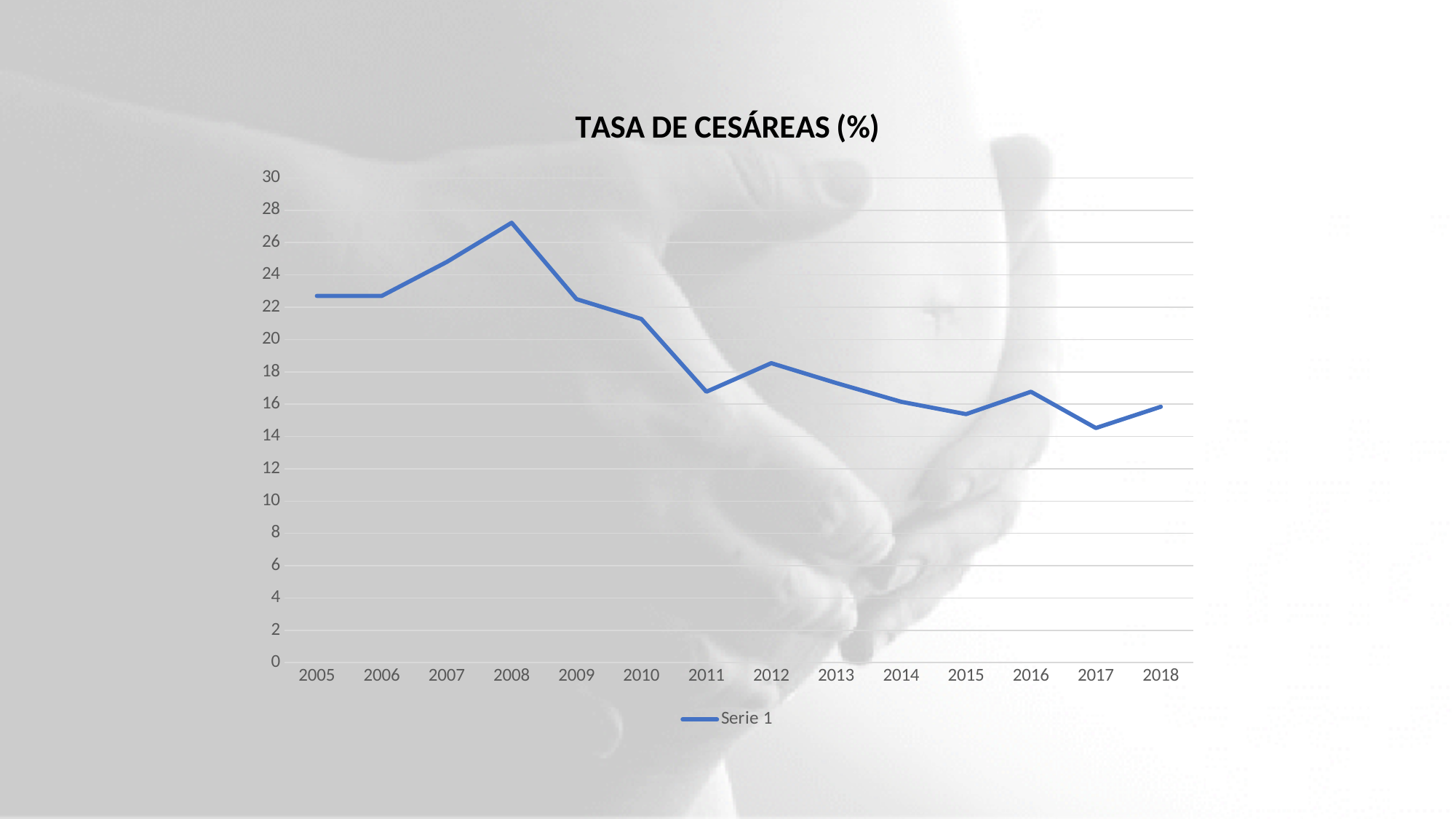
In which year is the cesarean rate highest? 2008 Overall, does the cesarean rate rise or fall from 2005 to 2018? fall Which year has the larger value, 2010 or 2011? 2010 What is the name of the series shown in the legend? Serie 1 Is the value for 2011 greater or less than 18? less What kind of chart is shown on the slide? line chart What is the title of the chart? TASA DE CESÁREAS (%) How many series does the legend list? 1 In which year is the cesarean rate lowest? 2017 How many years are plotted along the x axis? 14 Is the value for 2008 greater or less than 26? greater Is the value for 2017 greater or less than 16? less